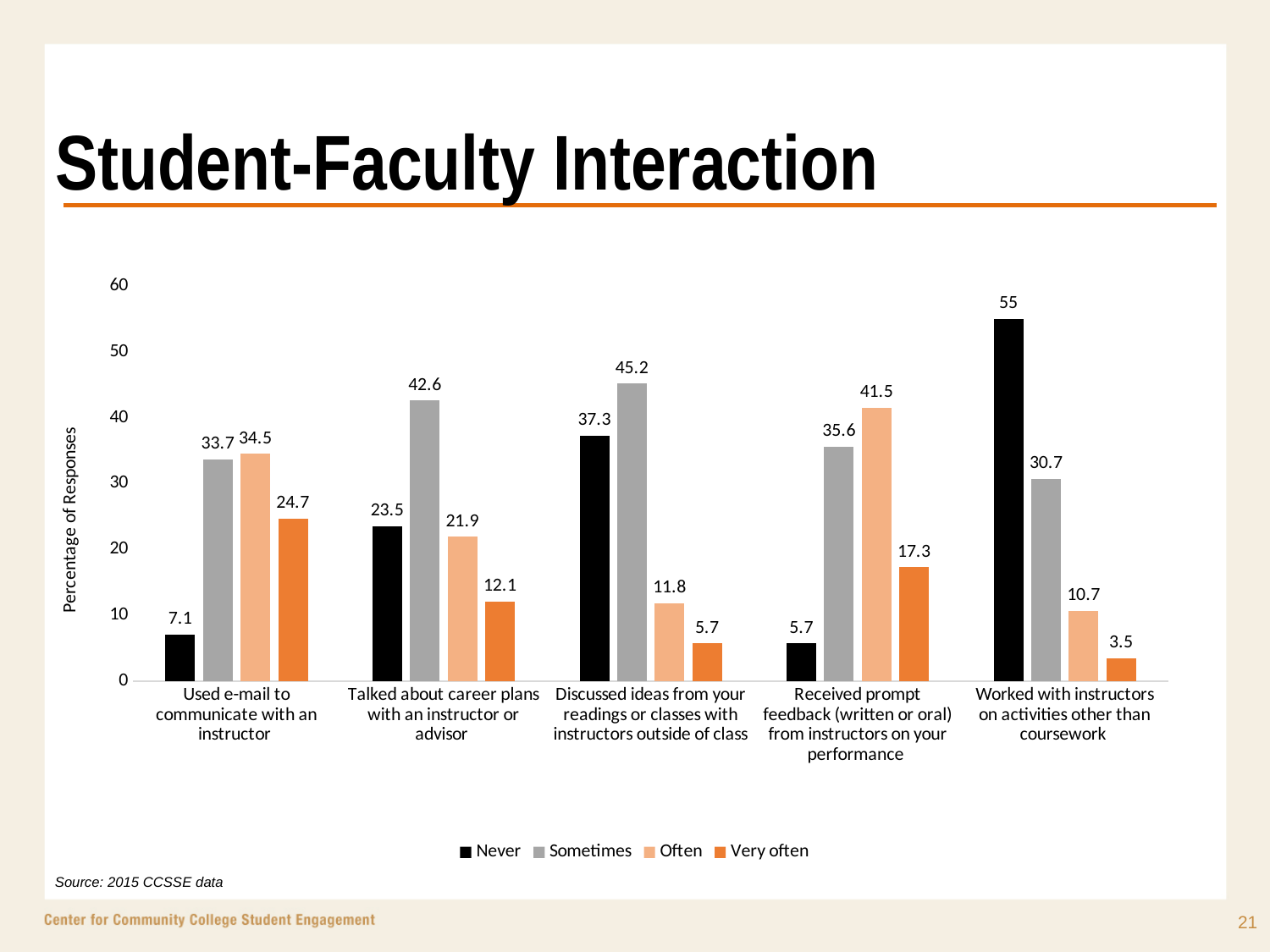
What is the value for "Very often" in the "Received prompt feedback (written or oral) from instructors on your performance" category? 17.3 Is the "Never" value for "Worked with instructors on activities other than coursework" greater or less than 50? greater Which category has the lowest "Very often" value? Worked with instructors on activities other than coursework What is the label of the y axis? Percentage of Responses What is the value for "Never" in the "Used e-mail to communicate with an instructor" category? 7.1 Which is larger in the "Used e-mail to communicate with an instructor" category: "Often" or "Very often"? Often What kind of chart is shown on the slide? Bar chart How many series does the legend list? 4 What is the difference between the "Sometimes" and "Never" values for "Discussed ideas from your readings or classes with instructors outside of class"? 7.9 Which category has the highest "Never" value? Worked with instructors on activities other than coursework How many categories are shown on the x axis? 5 What is the value for "Sometimes" in the "Talked about career plans with an instructor or advisor" category? 42.6